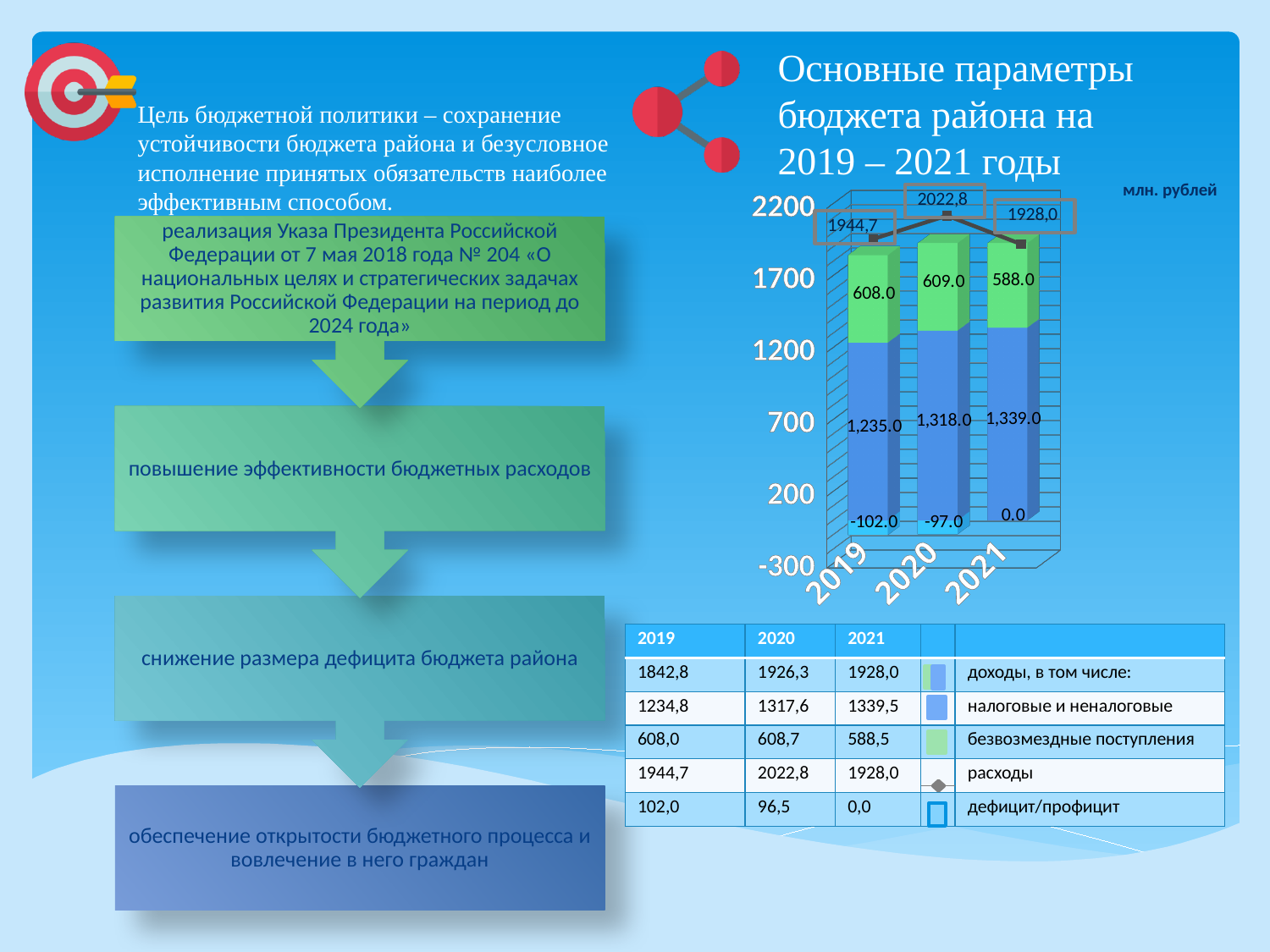
What is the data label for the blue (налоговые и неналоговые) segment for 2019? 1,235.0 What value does the line (расходы) show for 2020? 2022,8 What unit is indicated in the top right corner of the chart? млн. рублей Which year has the lowest blue (налоговые и неналоговые) segment value? 2019 Which year has the highest value on the расходы line? 2020 Do the blue (налоговые и неналоговые) segment values rise or fall from 2019 to 2021? rise What is the data label for the deficit (дефицит/профицит) for 2019? -102.0 What is the difference between the blue segment values for 2021 and 2019? 104.0 What is the data label for the green (безвозмездные поступления) segment for 2021? 588.0 How many years are shown on the x axis of the chart? 3 What type of chart is shown on the slide? bar chart Is the green segment value for 2020 larger or smaller than for 2021? larger